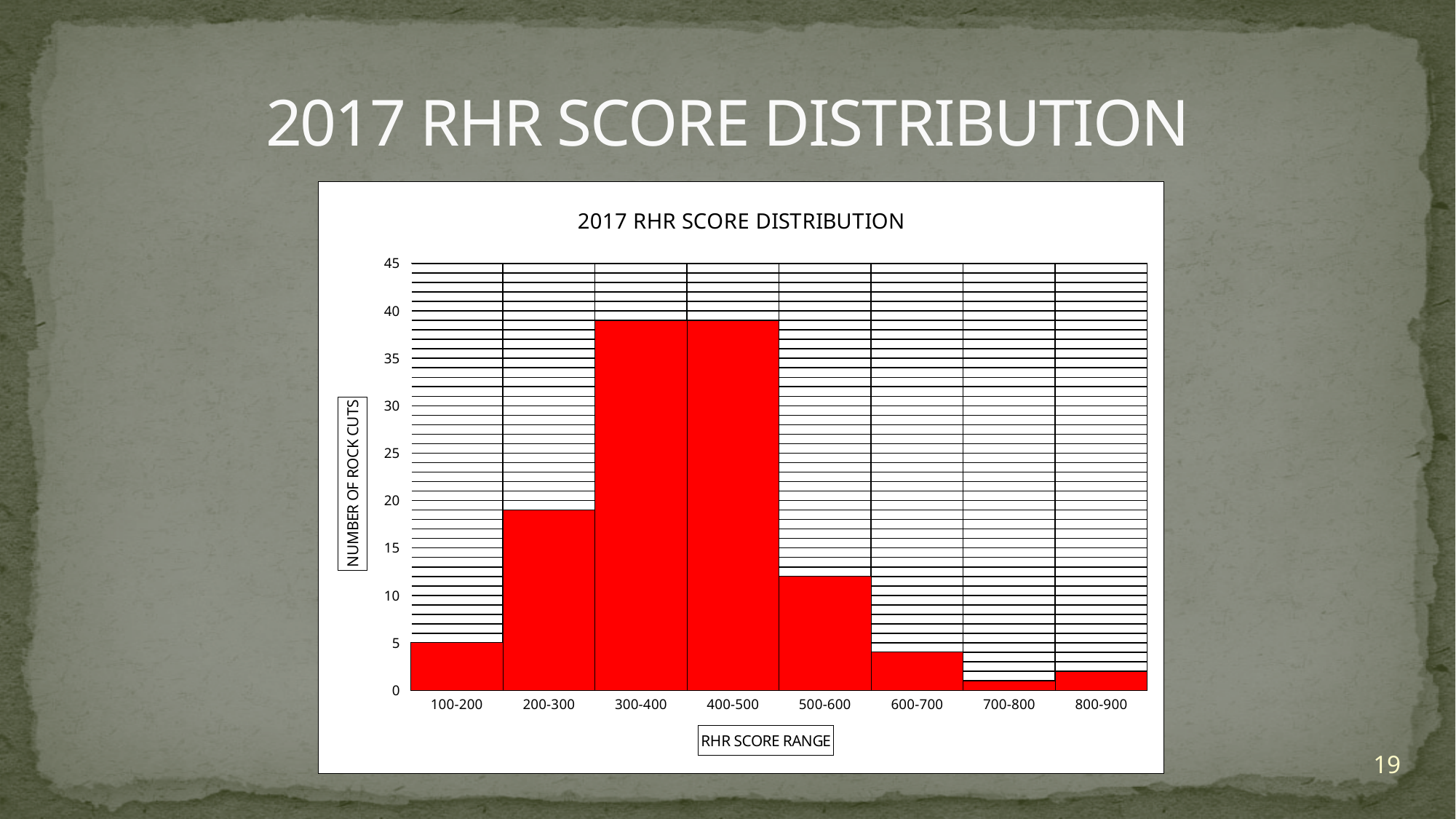
What is the number of rock cuts for the 100-200 score range? 5 Which has more rock cuts, the 200-300 range or the 500-600 range? 200-300 What kind of chart is shown on the slide? bar chart Is the value for the 500-600 score range greater or less than 10? greater Is the value for the 200-300 score range greater or less than 20? less Is the value for the 600-700 score range greater or less than 5? less What is the title of the chart? 2017 RHR SCORE DISTRIBUTION How many score ranges are shown on the x axis? 8 Which score range has the lowest number of rock cuts? 700-800 What is the label of the vertical axis? NUMBER OF ROCK CUTS Do the values rise or fall from the 100-200 range to the 300-400 range? rise